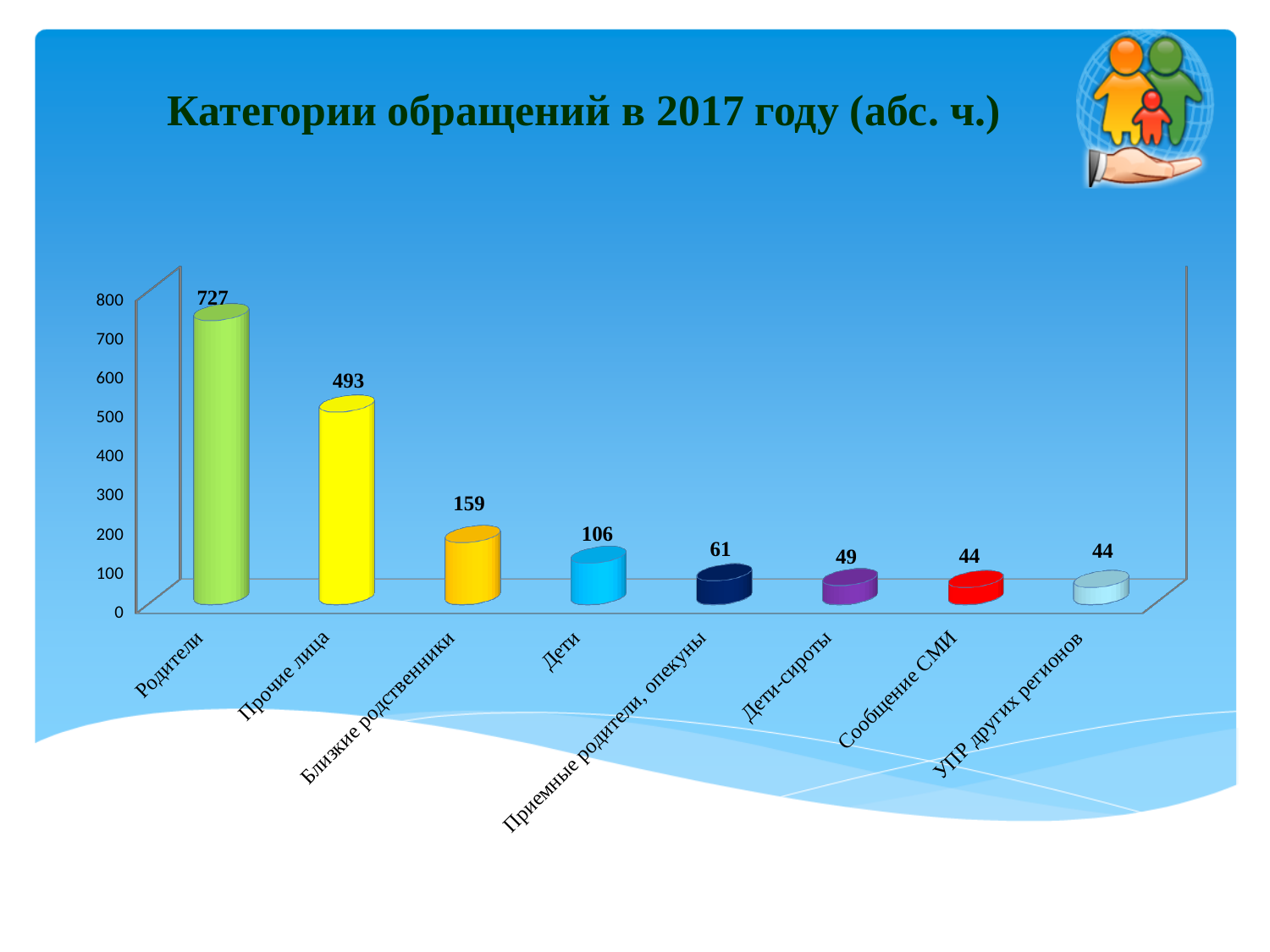
What kind of chart is shown on the slide? bar chart What is the value for Родители? 727 What is the difference between the values for Родители and Прочие лица? 234 What is the title of the chart? Категории обращений в 2017 году (абс. ч.) What is the value for Близкие родственники? 159 What is the difference between the values for Дети and Дети-сироты? 57 What is the value for Приемные родители, опекуны? 61 What is the value for Прочие лица? 493 Is the value for Прочие лица greater or less than 400? greater Which is larger, the value for Близкие родственники or the value for Дети? Близкие родственники Which category has the highest value? Родители How many categories are shown on the chart? 8